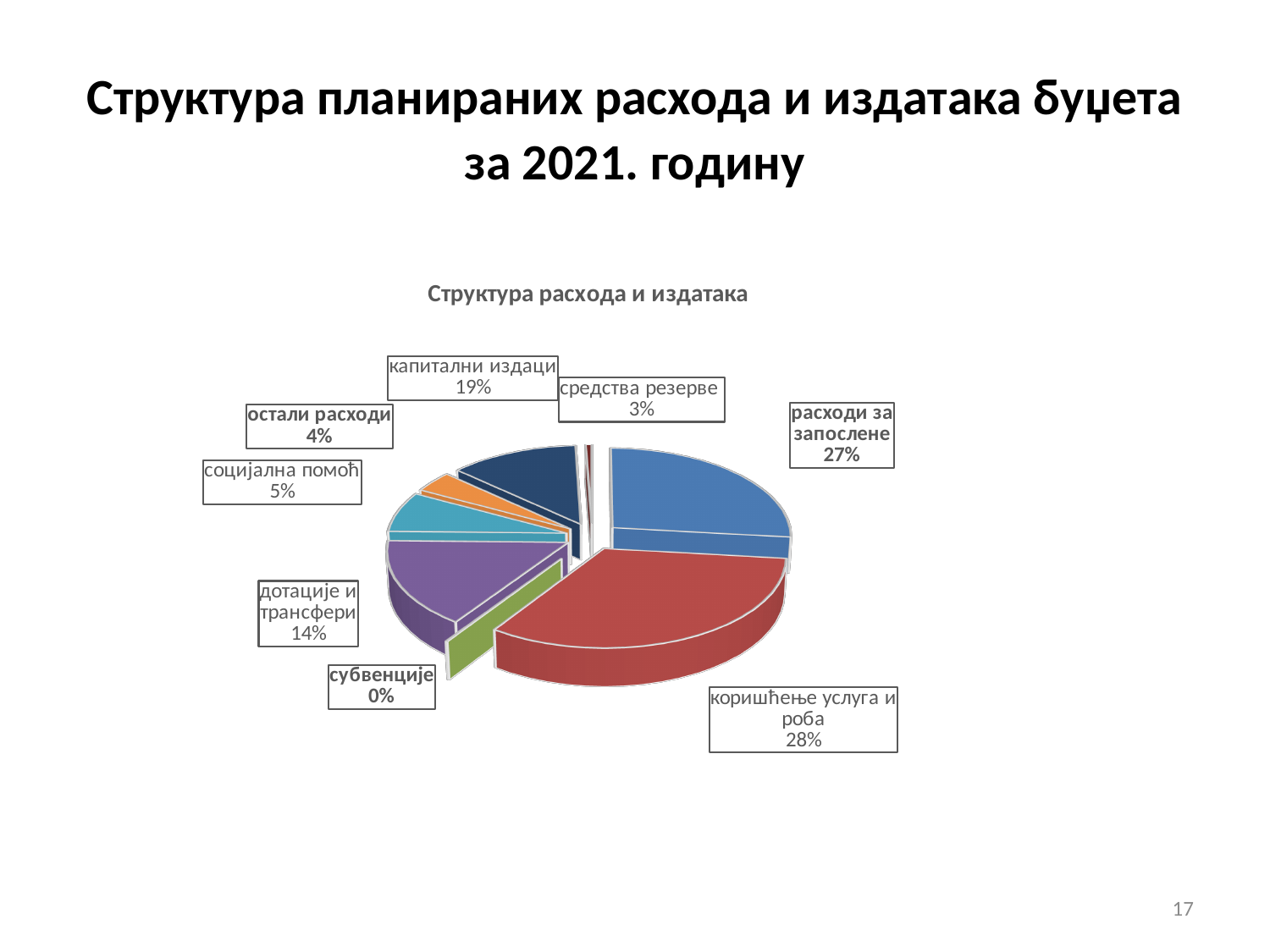
What percentage is shown for дотације и трансфери? 14% What share of the pie is labelled for капитални издаци? 19% What is the combined share of расходи за запослене and коришћење услуга и роба? 55% What percentage is shown for средства резерве? 3% What percentage is shown for расходи за запослене? 27% Which is larger, социјална помоћ or остали расходи? социјална помоћ Which category has the smallest share of the pie? субвенције What kind of chart is shown on the slide? pie chart How many categories are shown in the pie chart? 8 What is the difference in percentage points between капитални издаци and дотације и трансфери? 5 What is the title of the chart? Структура расхода и издатака Which category has the largest share of the pie? коришћење услуга и роба